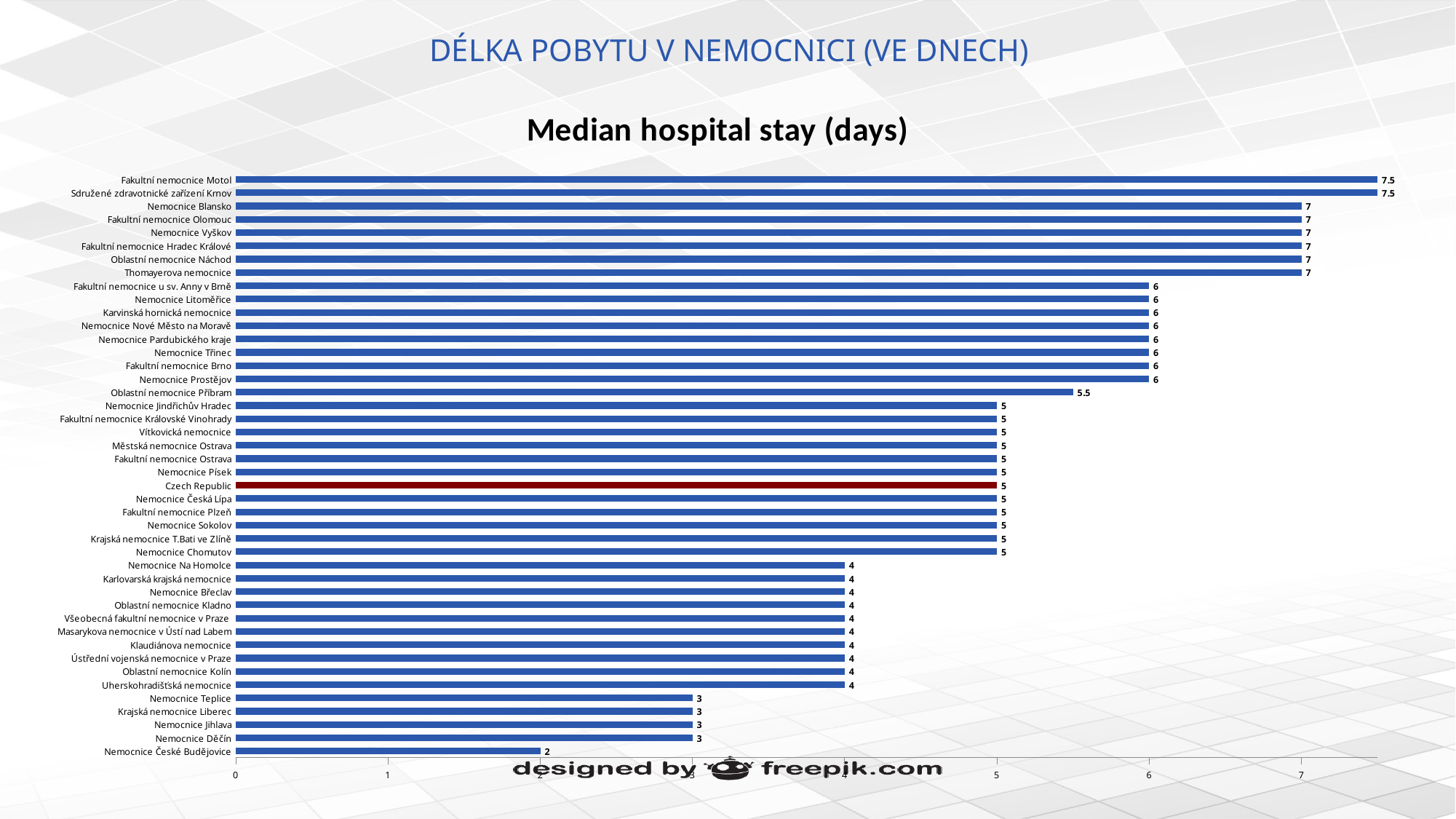
Is the median hospital stay for Sdružené zdravotnické zařízení Krnov greater or less than 7? greater What is the median hospital stay for Nemocnice Teplice? 3 What is the difference in median hospital stay between Nemocnice Blansko and Czech Republic? 2 What is the difference in median hospital stay between Fakultní nemocnice Motol and Nemocnice České Budějovice? 5.5 Which has a longer median hospital stay, Nemocnice Prostějov or Nemocnice Na Homolce? Nemocnice Prostějov What is the median hospital stay for Fakultní nemocnice Motol? 7.5 What is the median hospital stay for Czech Republic? 5 What type of chart is shown on the slide? Bar chart Which bar in the chart is coloured dark red instead of blue? Czech Republic What is the median hospital stay for Oblastní nemocnice Příbram? 5.5 What is the median hospital stay for Nemocnice České Budějovice? 2 Which hospital has the lowest median hospital stay? Nemocnice České Budějovice